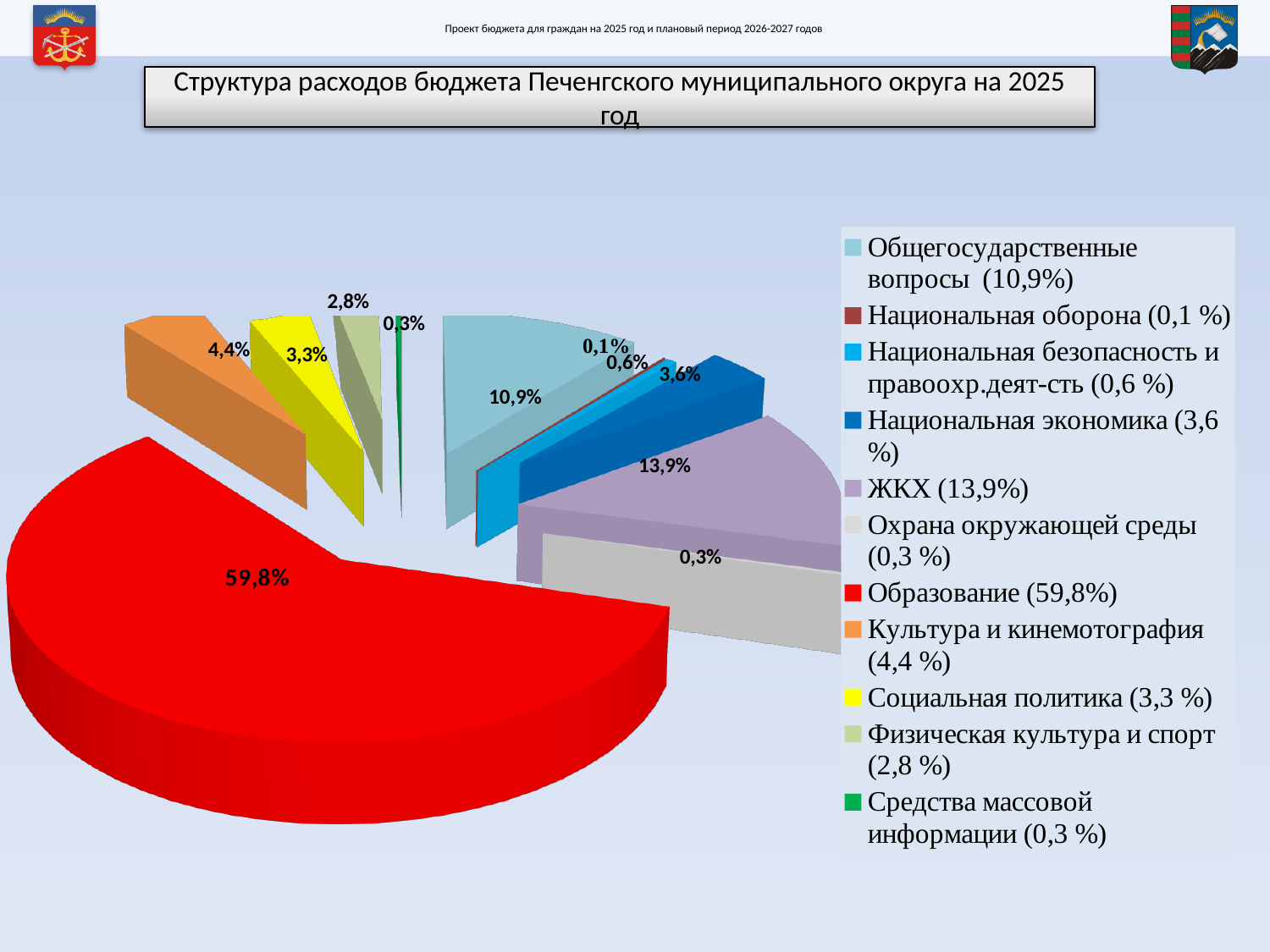
Which category has the largest share of the pie? Образование What colour is the slice for Образование? Red What is the value for Культура и кинемотография? 4,4% What share of the budget expenditure goes to Образование? 59,8% How many categories are shown in the pie chart? 11 Which is larger, the share for ЖКХ or the share for Общегосударственные вопросы? ЖКХ What is the value for ЖКХ? 13,9% Which category has the smallest share of the pie? Национальная оборона What is the value for Национальная экономика? 3,6% What is the difference between the shares of Образование and ЖКХ? 45,9% What is the value for Общегосударственные вопросы? 10,9% What kind of chart is shown on the slide? Pie chart